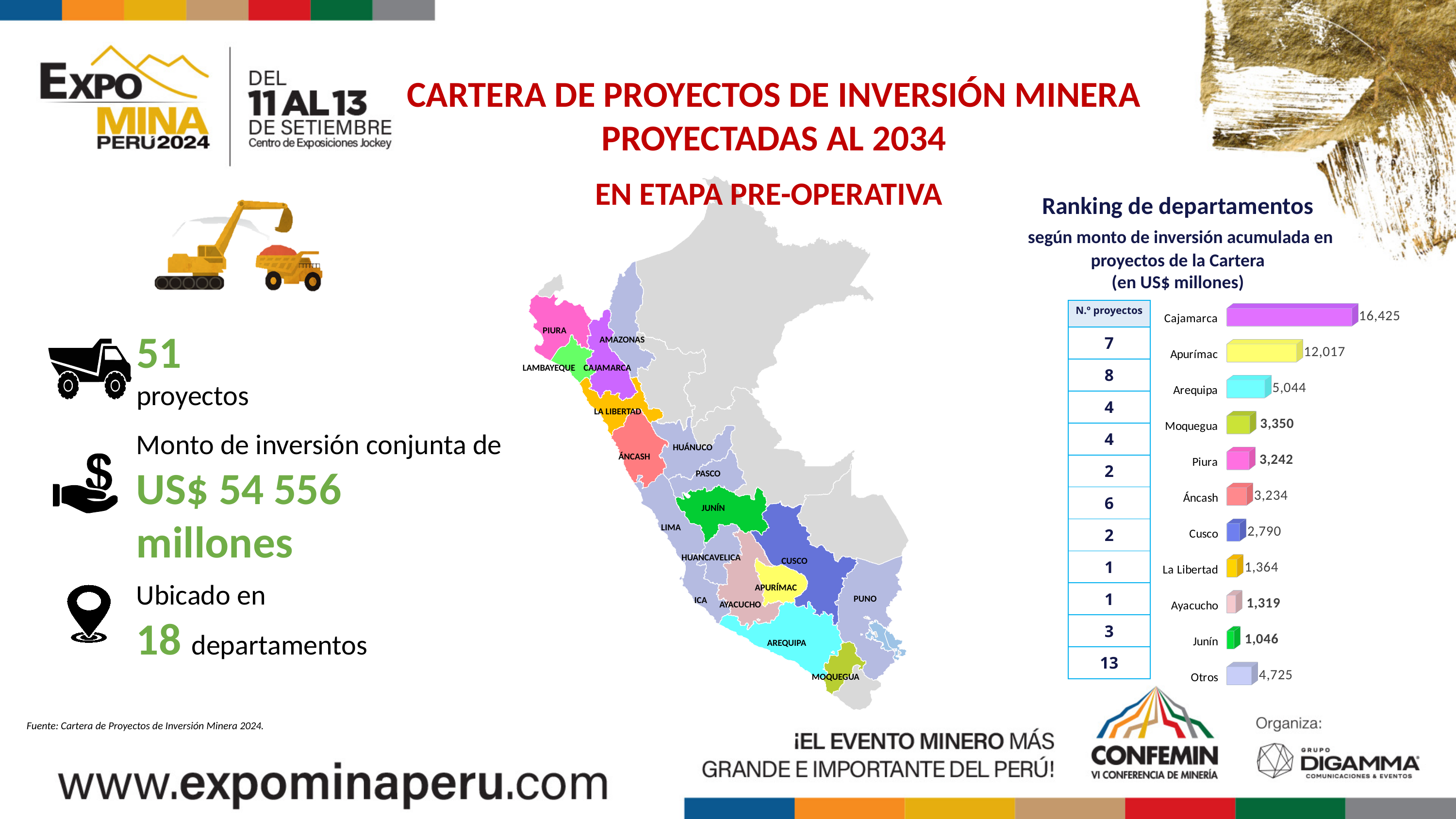
In the 'Ranking de departamentos' chart, which named department (excluding Otros) has the lowest investment amount? Junín In the 'N.° proyectos' table next to the 'Ranking de departamentos' chart, how many projects are listed for Apurímac? 8 In the 'Ranking de departamentos' chart, what is the difference between the investment amounts of Arequipa and Moquegua? 1,694 In the 'Ranking de departamentos' chart, what is the investment amount for Otros? 4,725 In the 'Ranking de departamentos' chart, what is the investment amount for Cajamarca? 16,425 In the 'Ranking de departamentos' chart, what is the difference between the investment amounts of Cajamarca and Apurímac? 4,408 In the 'Ranking de departamentos' chart, which has a larger investment amount, Apurímac or Arequipa? Apurímac How many categories (bars) are shown in the 'Ranking de departamentos' chart? 11 In the 'Ranking de departamentos' chart, what is the investment amount for Cusco? 2,790 In the 'Ranking de departamentos' chart, what is the investment amount for Arequipa? 5,044 What kind of chart is the 'Ranking de departamentos' chart? Bar chart In the 'Ranking de departamentos' chart, which department has the highest investment amount? Cajamarca